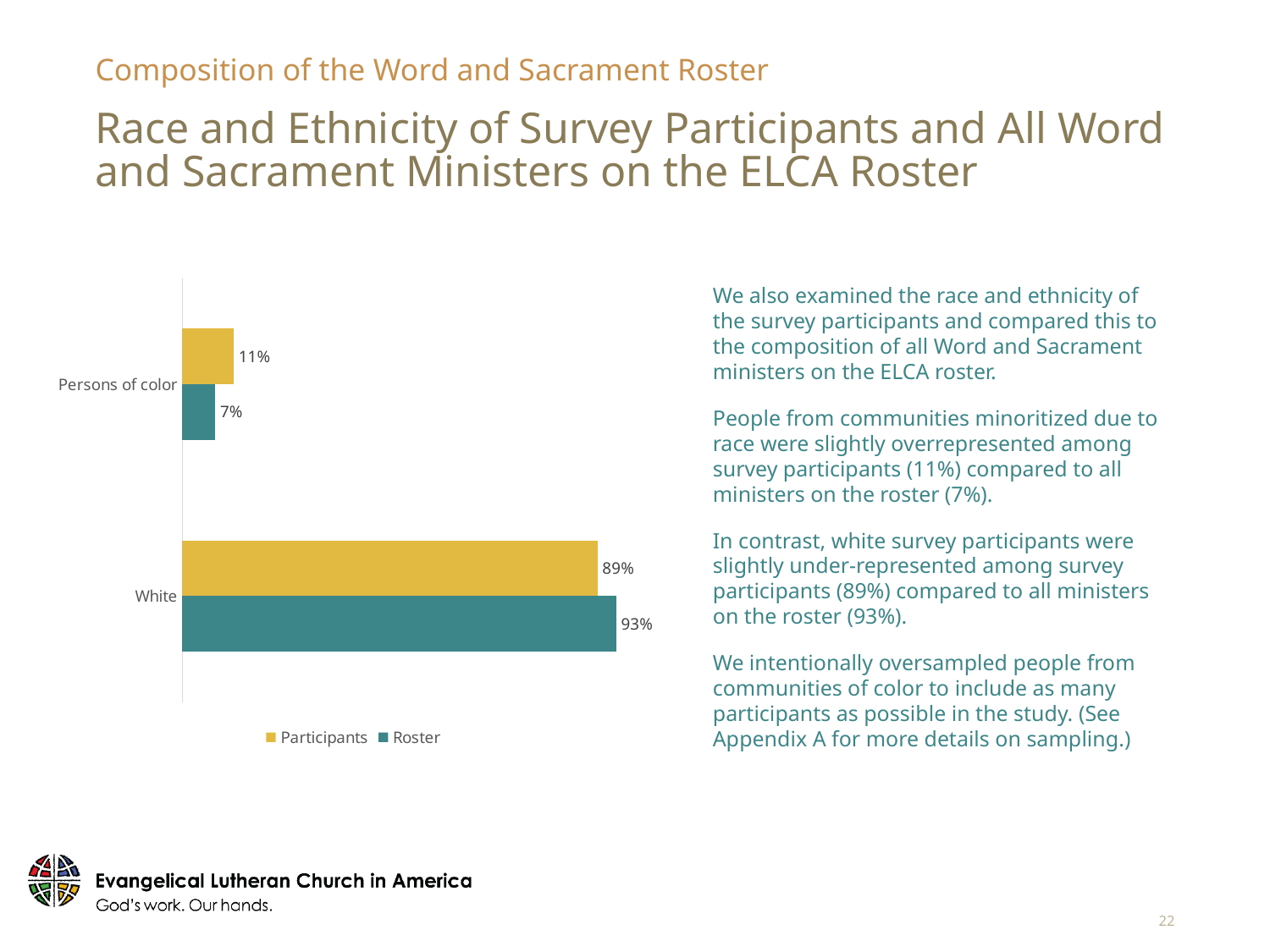
What is the difference between the Participants and Roster values for Persons of color? 4% Which category has the lowest Participants value? Persons of color Which category has the highest Roster value? White What is the Roster value for Persons of color? 7% What is the difference between the Roster and Participants values for White? 4% How many categories are shown on the chart? 2 What kind of chart is shown on the slide? Bar chart What is the Roster value for White? 93% How many series does the legend list? 2 What is the Participants value for Persons of color? 11% What is the Participants value for White? 89% For Persons of color, which is larger: the Participants value or the Roster value? Participants